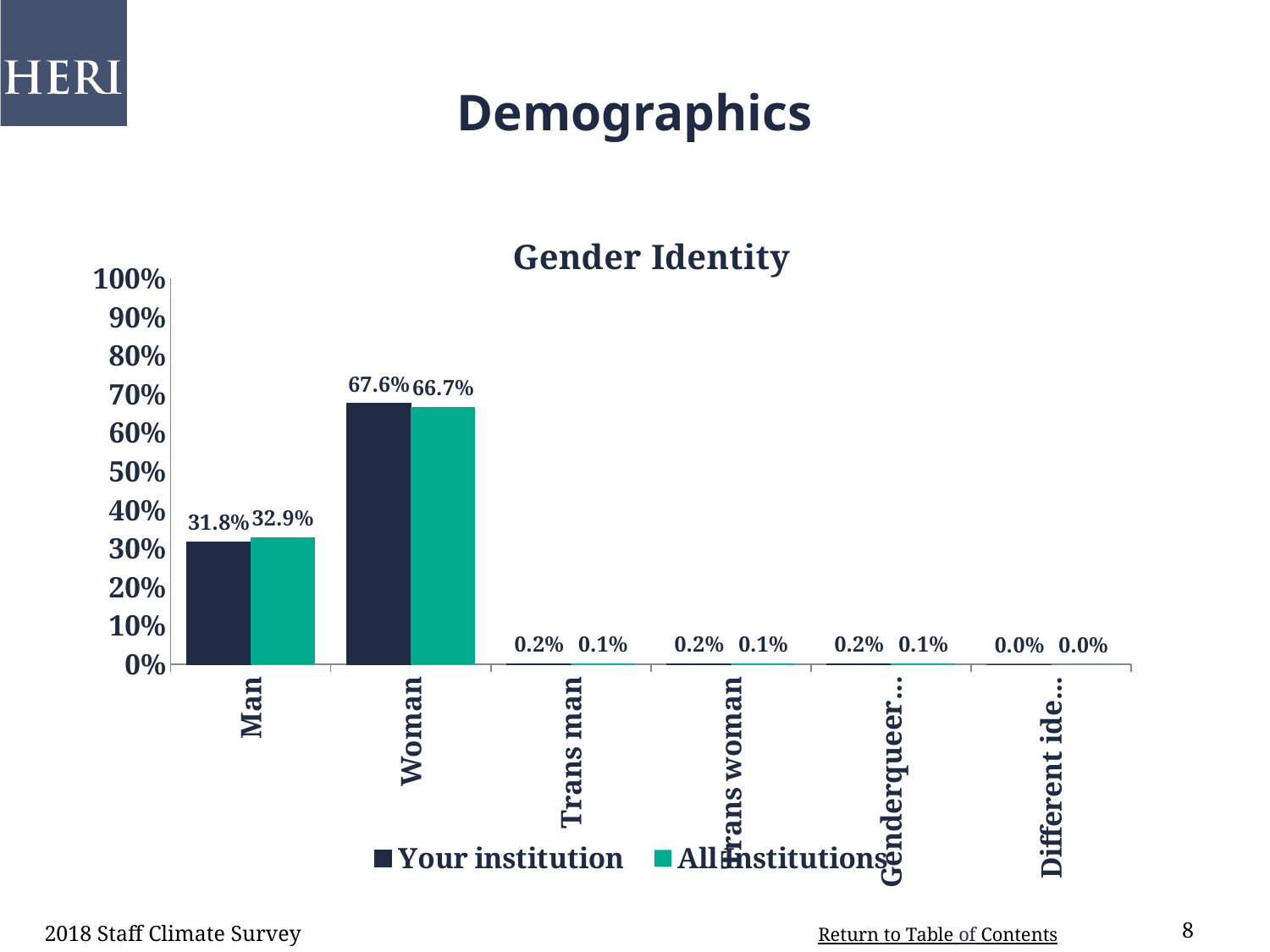
What kind of chart is shown on the slide? Bar chart Which category has the highest value in the Your institution series? Woman What is the value for Trans man in the Your institution series? 0.2% What is the value for Woman in the Your institution series? 67.6% For Man, which series has the larger value, Your institution or All institutions? All institutions Is the value for Woman in the Your institution series greater or less than 60%? greater What is the value for Man in the All institutions series? 32.9% What is the value for Trans woman in the All institutions series? 0.1% How many categories are shown on the x axis? 6 How many series does the legend list? 2 What is the difference between the Your institution and All institutions values for Woman? 0.9% What is the difference between the All institutions and Your institution values for Man? 1.1%